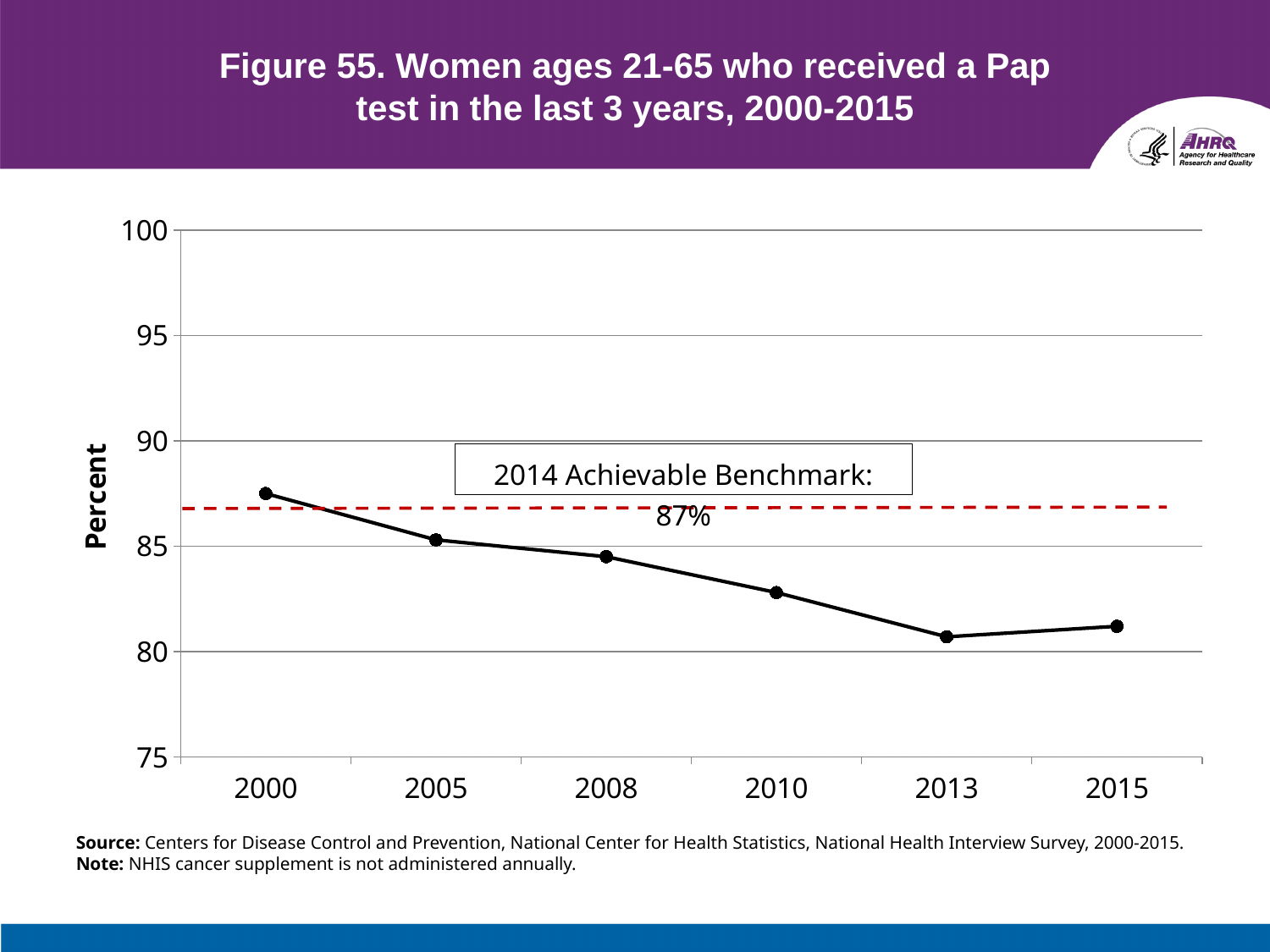
Which year has the highest percentage of women ages 21-65 who received a Pap test? 2000 Do the values generally rise or fall from 2000 to 2015? fall Is the value for 2000 greater or less than 85? greater Which year has the larger value, 2005 or 2010? 2005 What is the label on the y axis? Percent Is the value for 2000 greater or less than 90? less Which year has the lowest percentage of women ages 21-65 who received a Pap test? 2013 What kind of chart is shown on the slide? line chart Is the value for 2015 greater or less than 85? less What is the 2014 Achievable Benchmark shown on the chart? 87% How many years are plotted on the x axis? 6